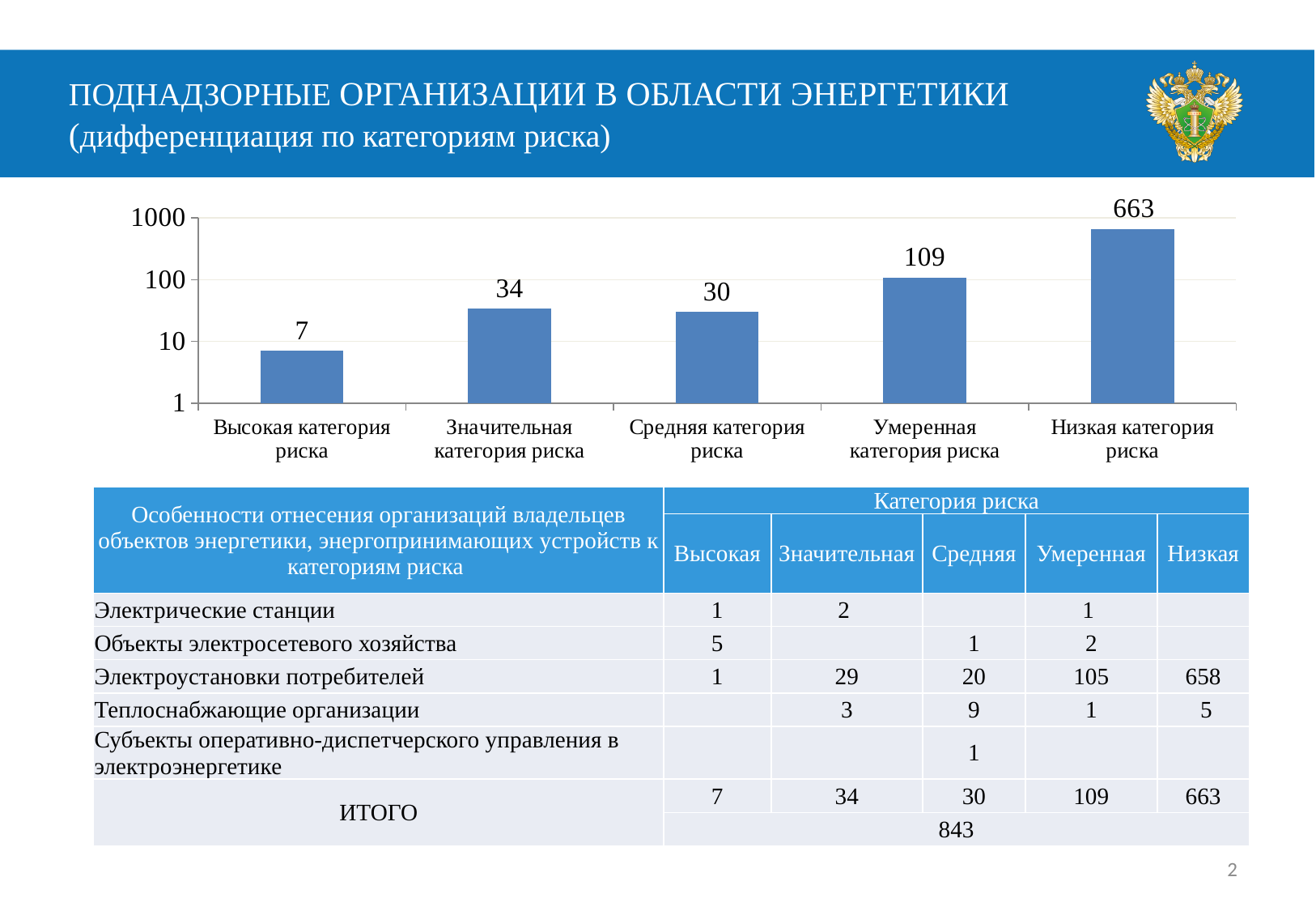
Which category has the lowest value? Высокая категория риска What is the value for Умеренная категория риска? 109 What is the difference between the values for Низкая категория риска and Умеренная категория риска? 554 What is the difference between the values for Значительная категория риска and Средняя категория риска? 4 How many categories are shown on the x axis of the chart? 5 What is the value for Значительная категория риска? 34 What is the value for Высокая категория риска? 7 What kind of chart is shown on the slide? bar chart Is the value for Умеренная категория риска greater or less than 100? greater Which is larger, the value for Значительная категория риска or the value for Средняя категория риска? Значительная категория риска Which category has the highest value? Низкая категория риска What is the value for Низкая категория риска? 663